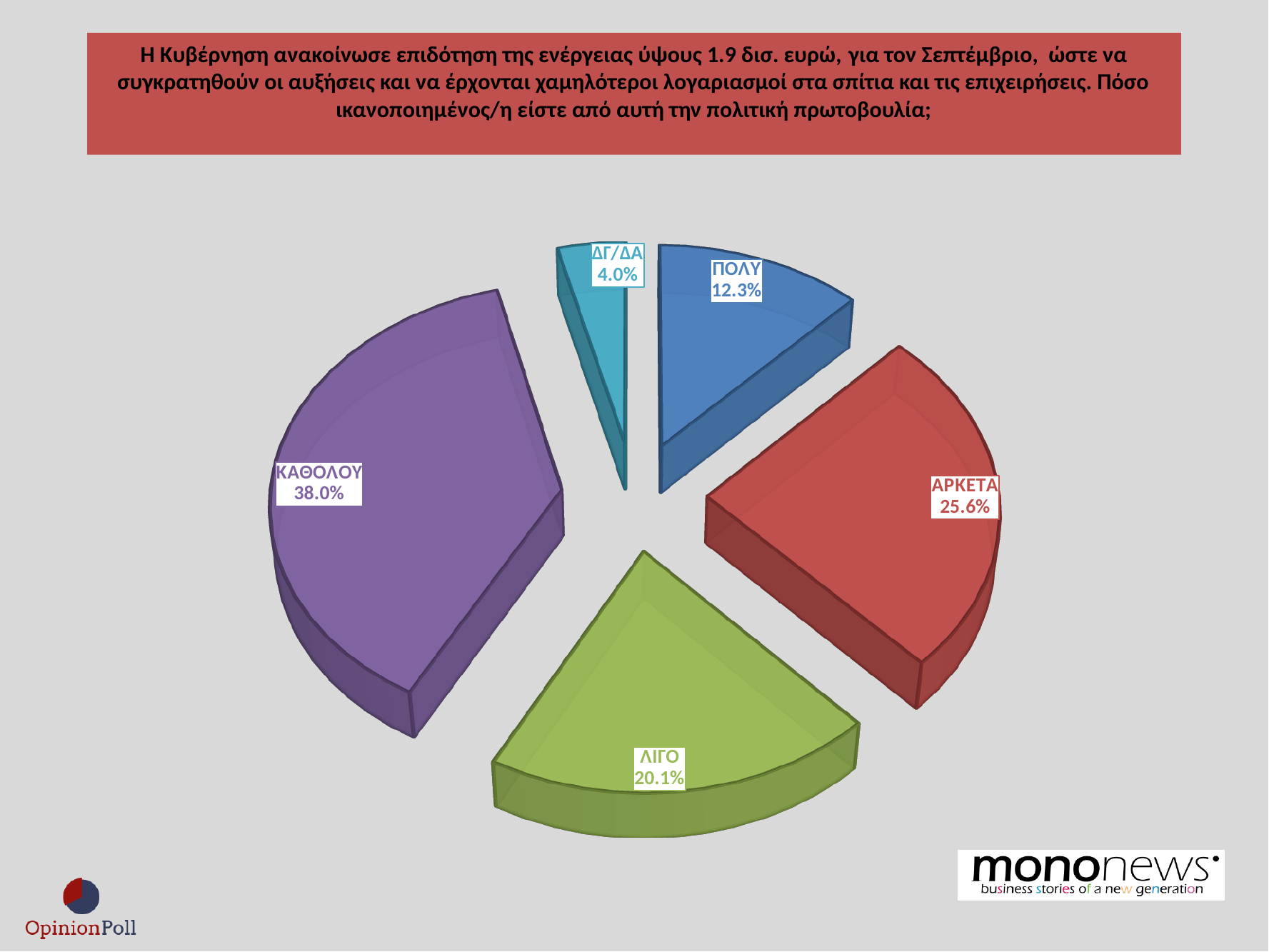
What percentage of respondents answered ΠΟΛΥ? 12.3% What kind of chart is shown on the slide? pie chart Which category has the smallest share of the pie? ΔΓ/ΔΑ How many slices does the pie chart have? 5 What colour is the ΚΑΘΟΛΟΥ slice? purple What is the value shown for the ΛΙΓΟ slice? 20.1% What percentage of respondents answered ΚΑΘΟΛΟΥ? 38.0% What is the value shown for the ΔΓ/ΔΑ slice? 4.0% What is the combined share of ΠΟΛΥ and ΑΡΚΕΤΑ? 37.9% Which category has the largest share of the pie? ΚΑΘΟΛΟΥ Which is larger, the share for ΑΡΚΕΤΑ or the share for ΛΙΓΟ? ΑΡΚΕΤΑ What is the difference in percentage points between ΚΑΘΟΛΟΥ and ΑΡΚΕΤΑ? 12.4